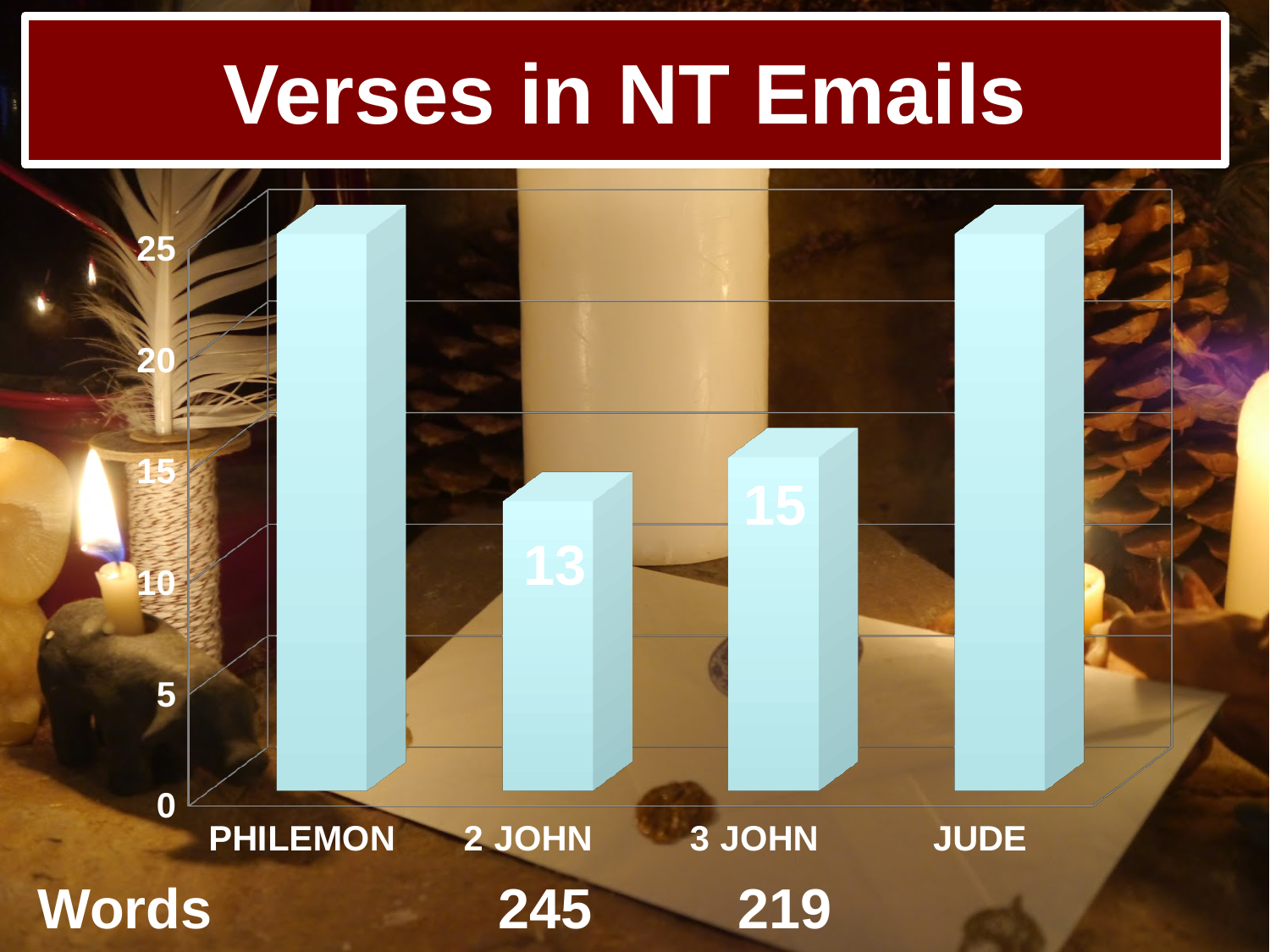
What is the value for 2 JOHN? 13 Which category has the lowest value? 2 JOHN What is the value for 3 JOHN? 15 Is the value for 2 JOHN greater or less than 15? less How many categories are shown on the x axis? 4 Which has a larger value, 2 JOHN or 3 JOHN? 3 JOHN What kind of chart is shown on the slide? bar chart What is the title of the chart? Verses in NT Emails Is the value for JUDE greater or less than 20? greater What is the label of the first category on the x axis? PHILEMON Is the value for PHILEMON greater or less than 20? greater What is the difference between the values for 3 JOHN and 2 JOHN? 2